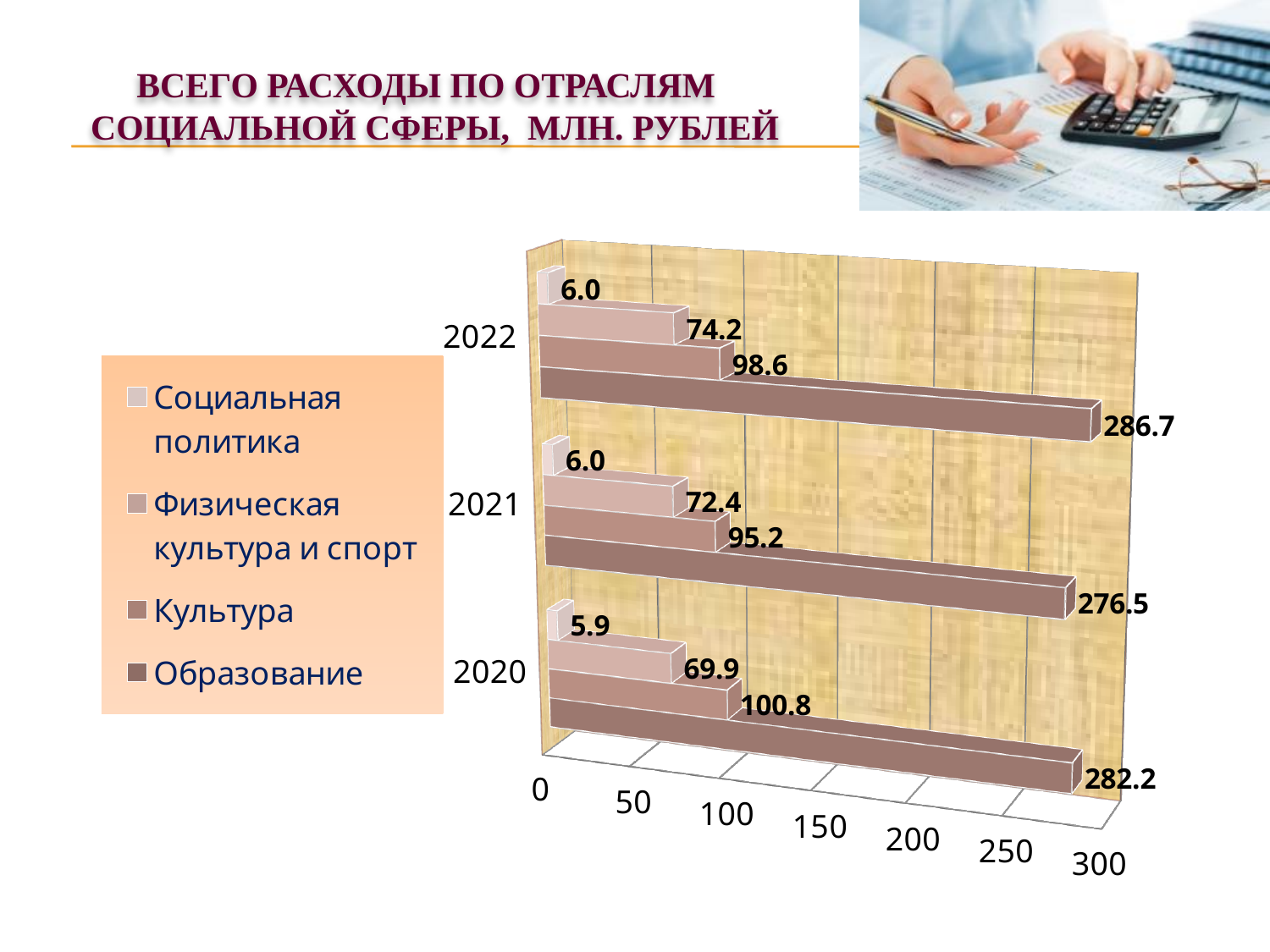
Which is larger: the Культура value for 2020 or for 2022? 2020 What is the value for Физическая культура и спорт in 2021? 72.4 What is the difference between the Образование values for 2022 and 2021? 10.2 How many series does the legend list? 4 In which year is the value for Образование the highest? 2022 What is the title of the chart? ВСЕГО РАСХОДЫ ПО ОТРАСЛЯМ СОЦИАЛЬНОЙ СФЕРЫ, МЛН. РУБЛЕЙ How many years are shown on the chart? 3 What is the value for Социальная политика in 2020? 5.9 In which year is the value for Физическая культура и спорт the lowest? 2020 What is the value for Образование in 2022? 286.7 What kind of chart is shown on the slide? Bar chart What is the value for Культура in 2020? 100.8